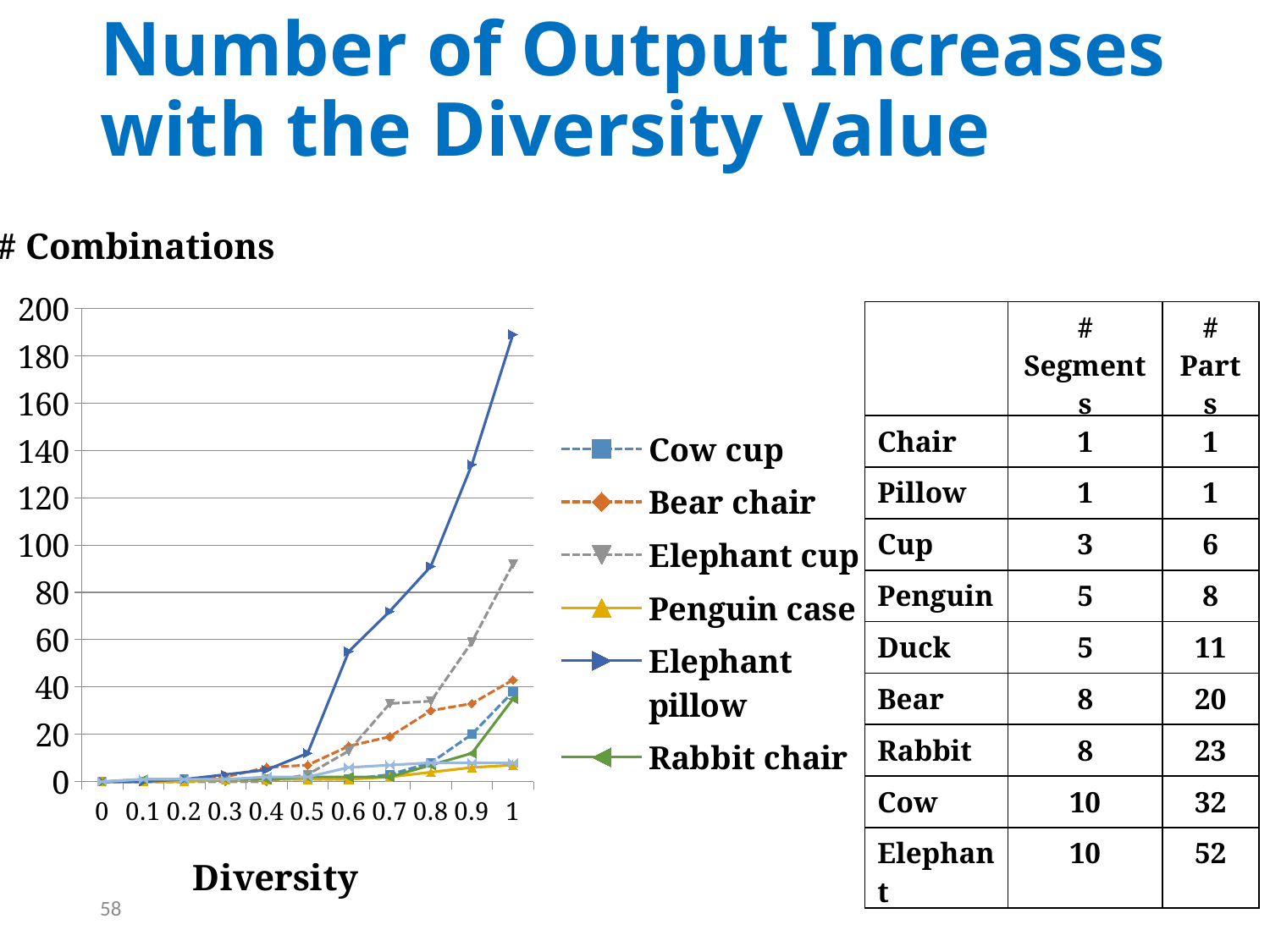
Is the value for Penguin case at diversity 1 greater or less than 20? less Is the value for Elephant cup at diversity 1 greater or less than 100? less What kind of chart is shown on the slide? line chart How many series does the chart's legend list? 6 At diversity 1, which is larger: Elephant cup or Bear chair? Elephant cup Is the value for Elephant pillow at diversity 1 greater or less than 180? greater What quantity does the y axis of the chart represent? # Combinations How many diversity values are marked along the x axis of the chart? 11 What is the label on the x axis of the chart? Diversity Does the Elephant pillow series rise or fall as diversity increases from 0 to 1? rise Which series has the highest value at diversity 1? Elephant pillow